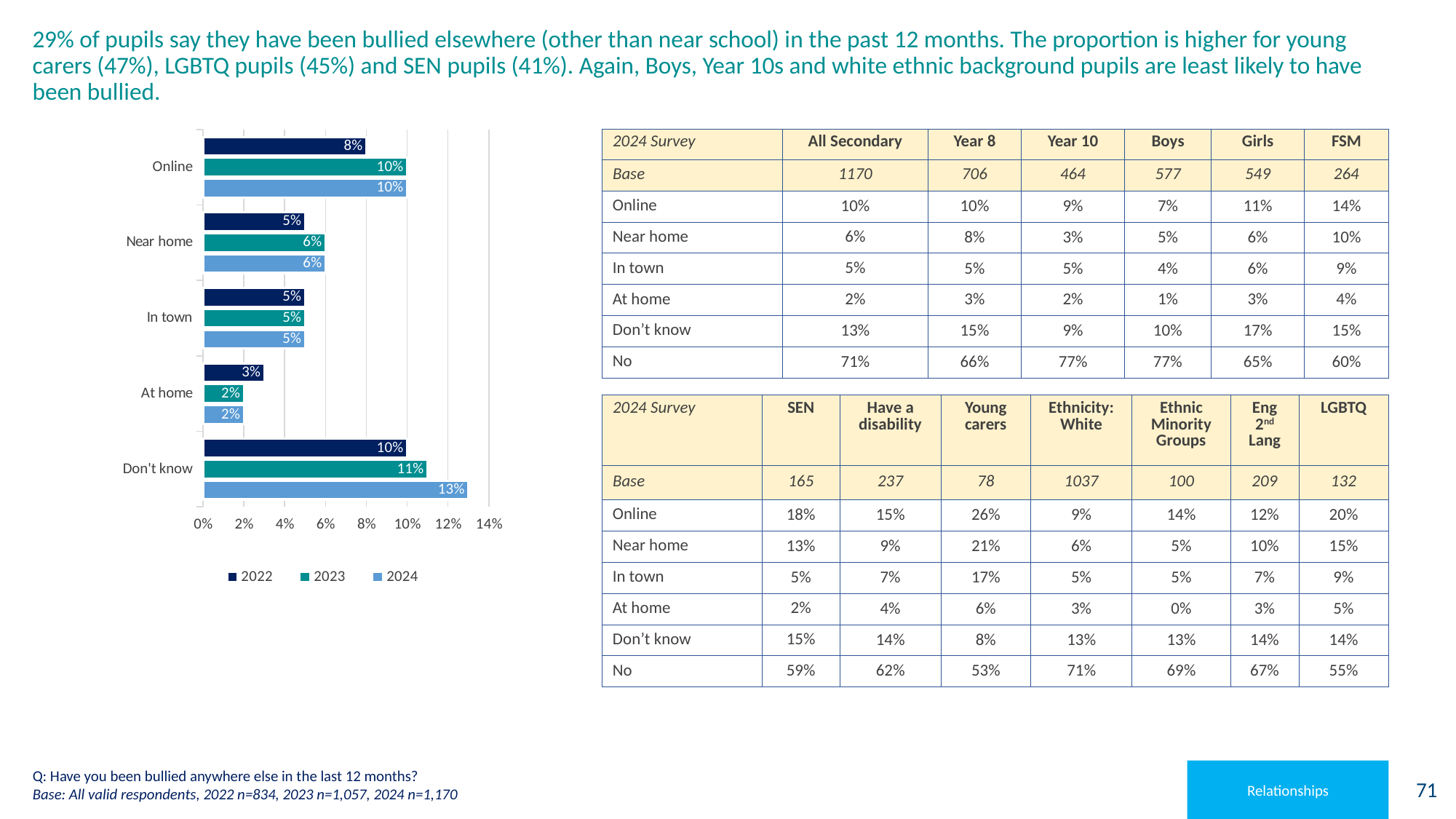
Which category has the lowest 2023 value in the bar chart? At home What is the 2022 value for At home in the bar chart? 3% What type of chart is shown on the slide? bar chart What is the difference between the 2024 and 2022 values for Don't know in the bar chart? 3% Which years are listed in the bar chart legend? 2022, 2023, 2024 What is the 2024 value for Online in the bar chart? 10% In the bar chart, is the 2022 value for Online larger or smaller than the 2023 value for Online? smaller How many series does the bar chart legend list? 3 Which category has the highest 2024 value in the bar chart? Don't know How many categories are shown on the bar chart? 5 What is the 2022 value for Don't know in the bar chart? 10% What is the 2023 value for Near home in the bar chart? 6%